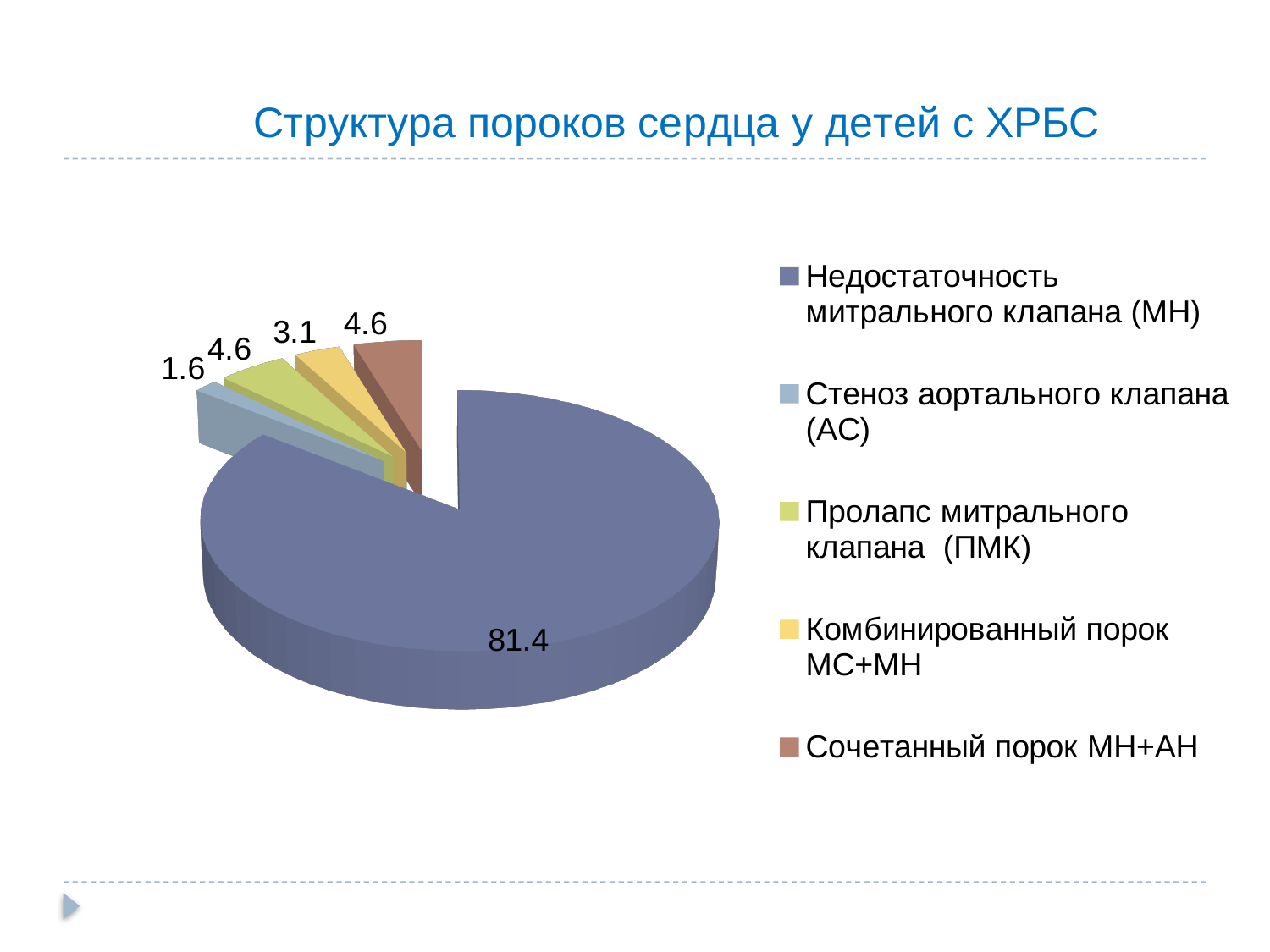
What is the value for Недостаточность митрального клапана (МН)? 81.4 What is the difference between the values for Недостаточность митрального клапана (МН) and Комбинированный порок МС+МН? 78.3 What is the value for Сочетанный порок МН+АН? 4.6 What is the value for Пролапс митрального клапана (ПМК)? 4.6 Which category has the largest slice? Недостаточность митрального клапана (МН) What type of chart is shown on the slide? Pie chart How many categories does the legend list? 5 What is the value for Комбинированный порок МС+МН? 3.1 What is the value for Стеноз аортального клапана (АС)? 1.6 Which category has the smallest slice? Стеноз аортального клапана (АС) Which is larger: the value for Пролапс митрального клапана (ПМК) or Комбинированный порок МС+МН? Пролапс митрального клапана (ПМК) What is the title of the chart? Структура пороков сердца у детей с ХРБС